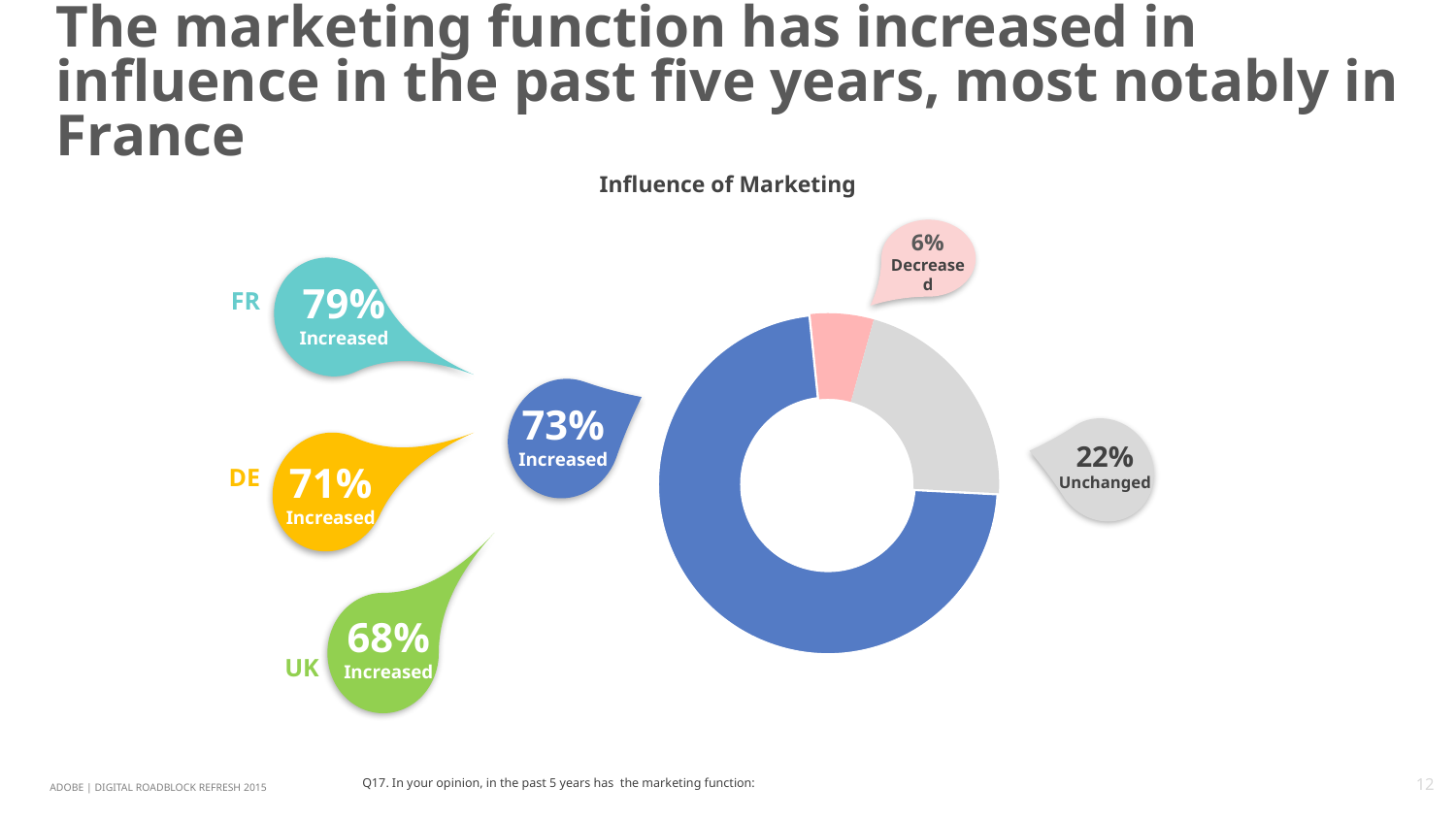
What share of respondents said the influence of marketing has decreased? 6% What is the difference in percentage points between the Increased and Unchanged slices? 51 percentage points What share of respondents said the influence of marketing has increased? 73% What share of respondents said the influence of marketing is unchanged? 22% What percentage of respondents in Germany (DE) said the influence of marketing has increased? 71% What kind of chart is shown under the title "Influence of Marketing"? Donut (pie) chart Which country has the highest share of respondents saying the influence of marketing has increased: FR, DE or UK? FR Which response category has the smallest slice of the donut chart? Decreased What percentage of respondents in the UK said the influence of marketing has increased? 68% Which response category has the largest slice of the donut chart? Increased How many slices does the donut chart have? 3 What percentage of respondents in France (FR) said the influence of marketing has increased? 79%